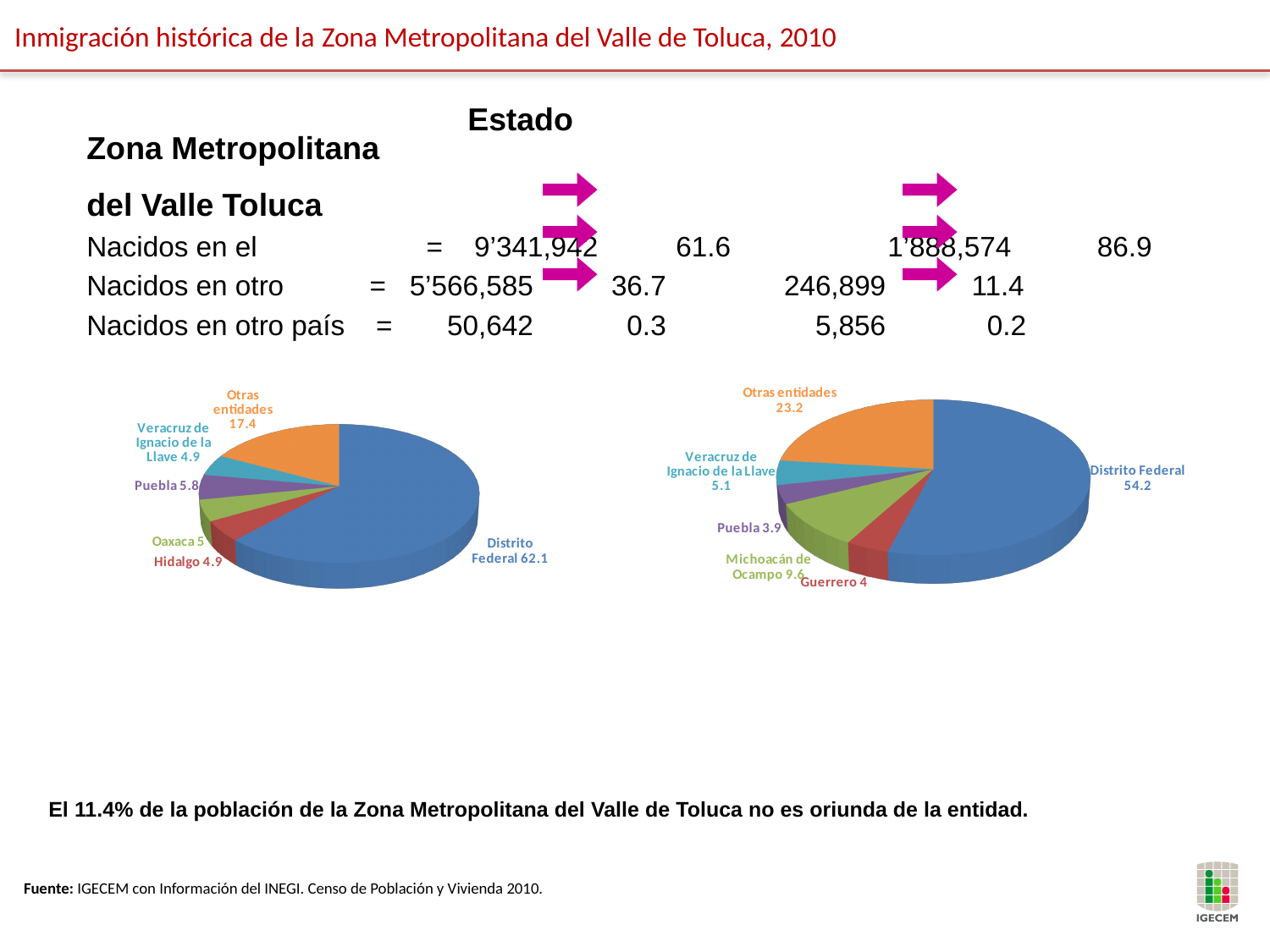
In the right pie chart, which category has the largest slice? Distrito Federal In the right pie chart, which is larger, Michoacán de Ocampo or Veracruz de Ignacio de la Llave? Michoacán de Ocampo In the left pie chart, what is the value for Puebla? 5.8 In the left pie chart, what is the value for Distrito Federal? 62.1 In the right pie chart, which category has the smallest slice? Puebla In the right pie chart, what is the value for Michoacán de Ocampo? 9.6 In the right pie chart, what is the value for Guerrero? 4 What kind of chart is the right chart on the slide? Pie chart How many slices does the left pie chart have? 6 In the left pie chart, what is the value for Otras entidades? 17.4 In the left pie chart, what is the difference between Distrito Federal and Otras entidades? 44.7 In the right pie chart, what is the value for Distrito Federal? 54.2